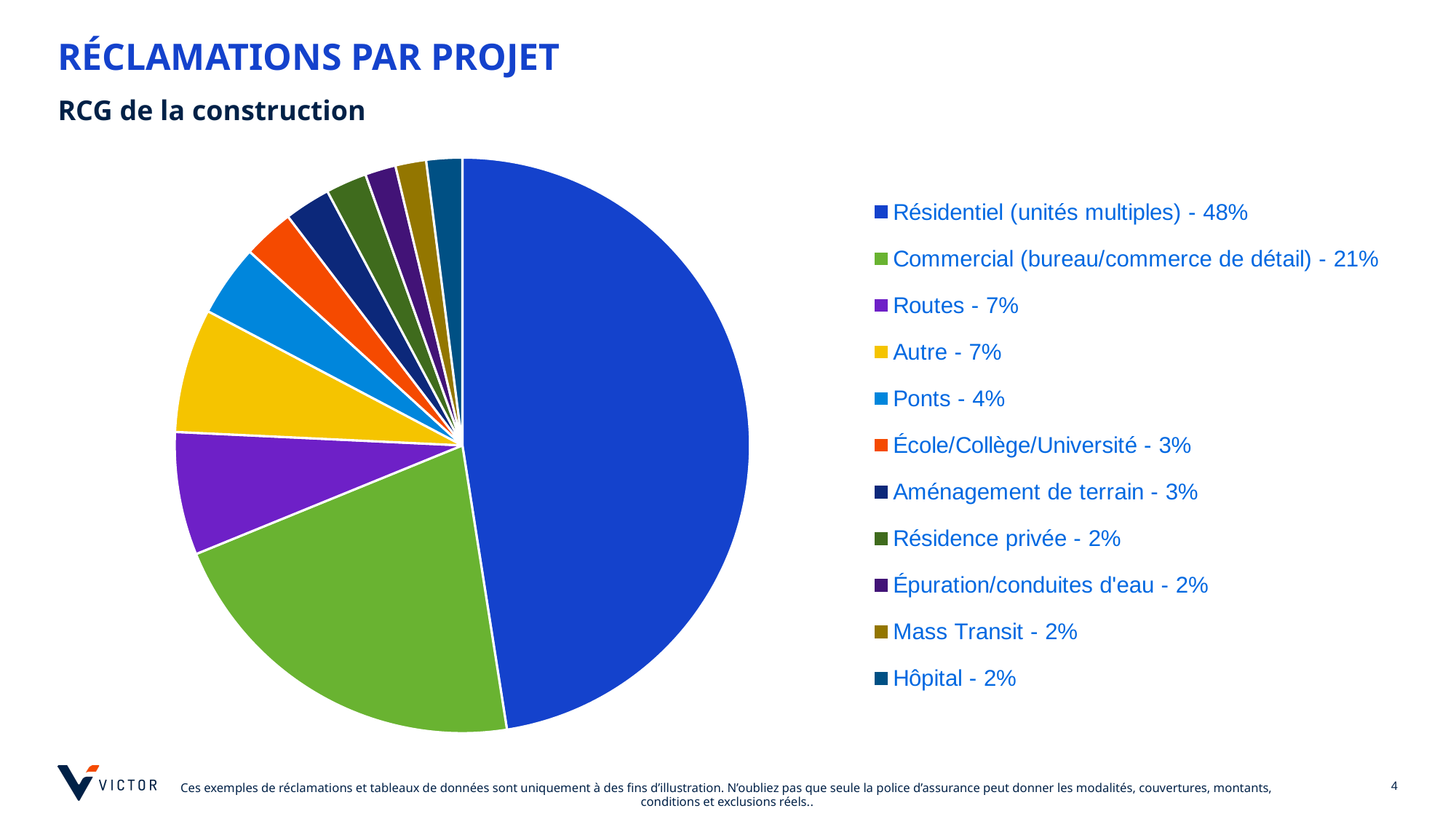
Which is larger, the share for Routes or the share for Ponts? Routes What colour is the slice for Autre? yellow What kind of chart is shown on the slide? pie chart Which category has the largest share of the pie? Résidentiel (unités multiples) What percentage is shown for Ponts? 4% How many categories does the legend list? 11 What is the combined share of Routes and Autre? 14% What percentage is shown for Commercial (bureau/commerce de détail)? 21% What is the difference in percentage points between Résidentiel (unités multiples) and Commercial (bureau/commerce de détail)? 27 What share of claims is attributed to Résidentiel (unités multiples)? 48% What percentage is shown for École/Collège/Université? 3% What is the title of the slide containing the chart? RÉCLAMATIONS PAR PROJET